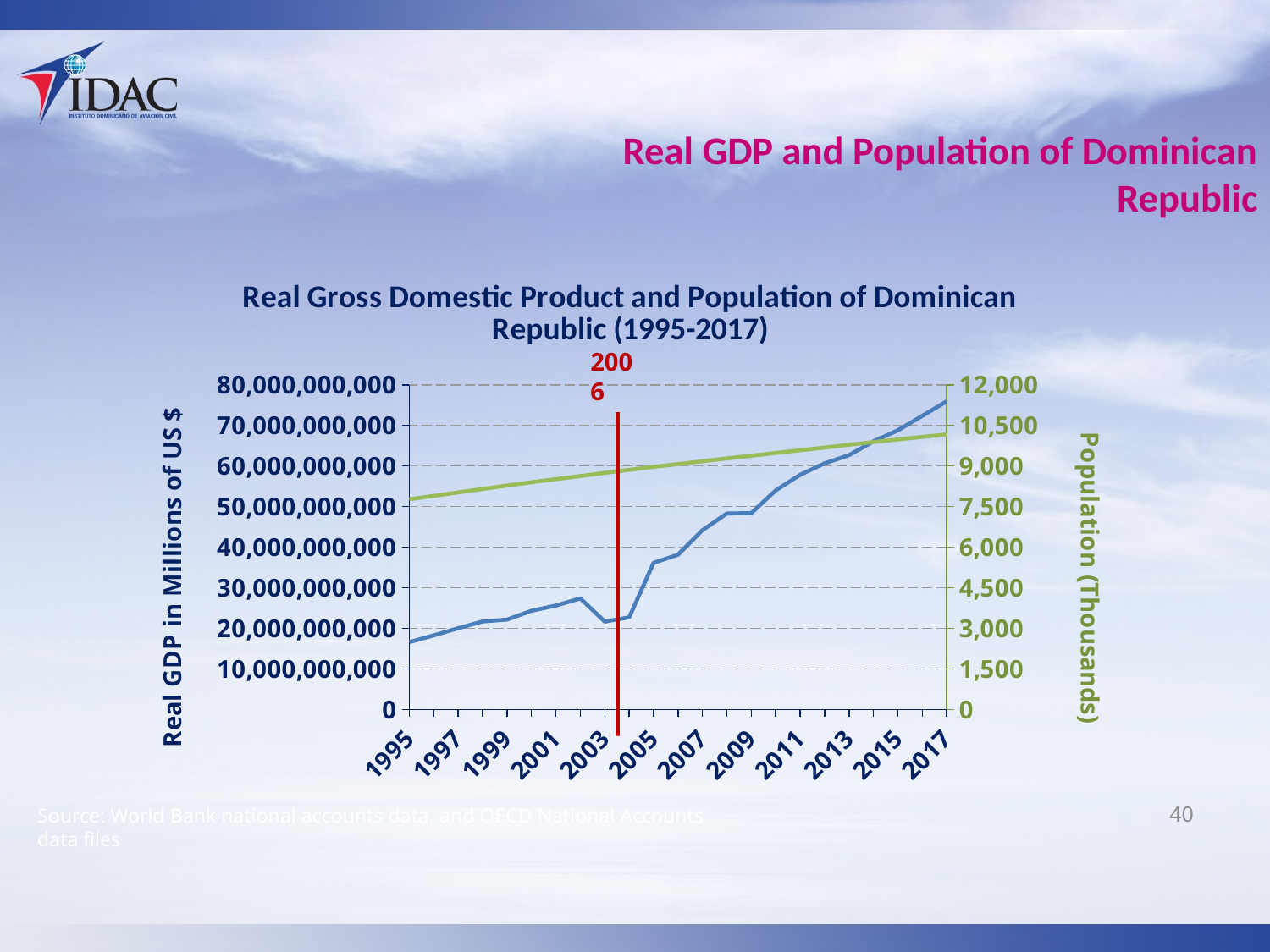
How many year labels are shown on the x axis? 12 Is the Real GDP value for 2011 greater or less than 50,000,000,000? greater What is the label of the left vertical axis? Real GDP in Millions of US $ How many data series (lines) are plotted on the chart? 2 Is the Real GDP value for 1995 greater or less than 20,000,000,000? less Is the Real GDP value for 2017 greater or less than 70,000,000,000? greater Does the Population line rise or fall from 1995 to 2017? Rise Which year has the higher Real GDP, 1995 or 2017? 2017 Does the Real GDP line generally rise or fall from 1995 to 2017? Rise What is the title of the chart? Real Gross Domestic Product and Population of Dominican Republic (1995-2017) What type of chart is shown on the slide? Line chart